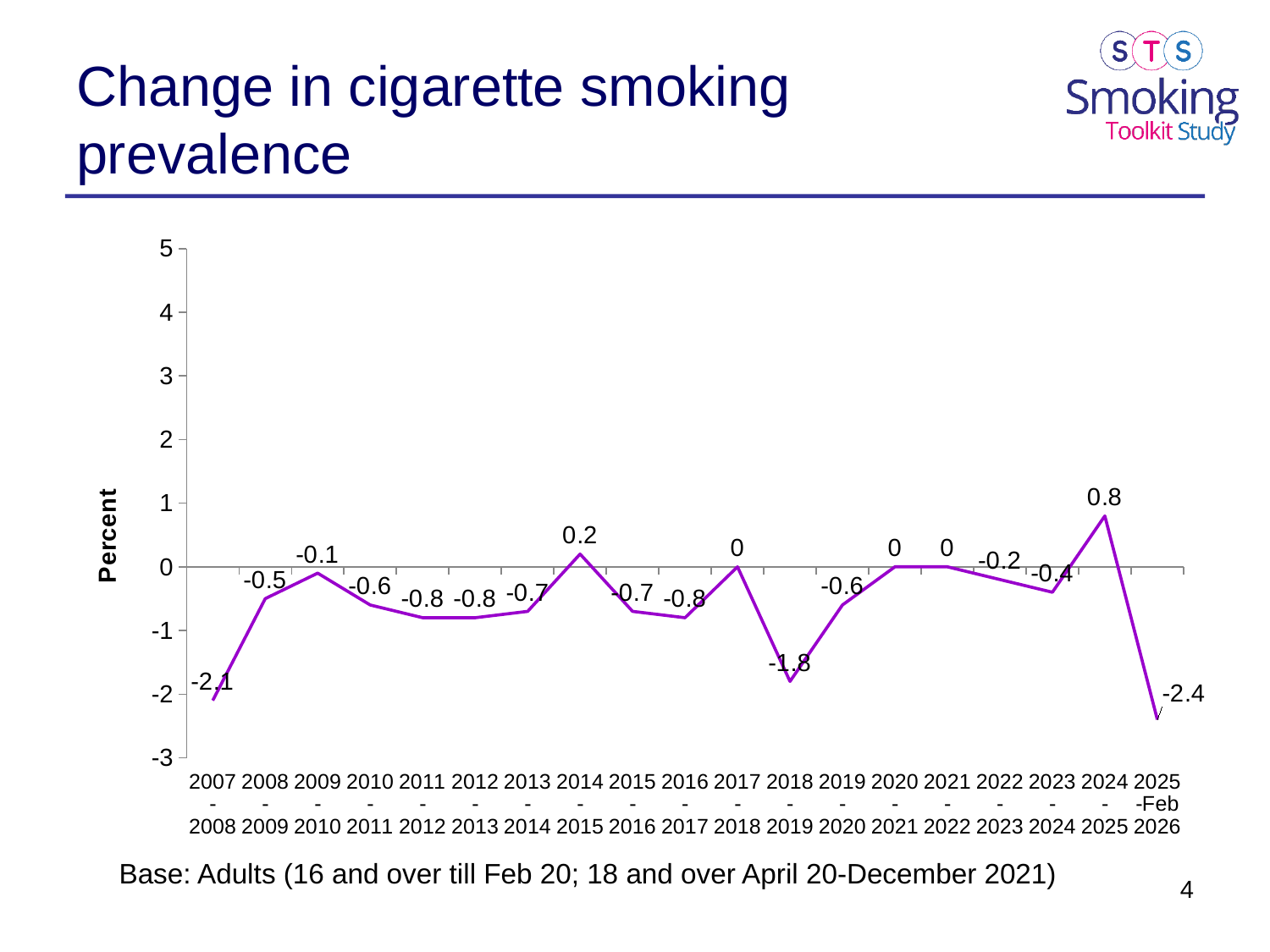
Which period has the lowest value? 2025-Feb 2026 What is the value for 2014-2015? 0.2 What is the value for 2025-Feb 2026? -2.4 Which is larger, the value for 2009-2010 or the value for 2011-2012? 2009-2010 What is the value for 2018-2019? -1.8 What is the label on the y axis? Percent Which period has the highest value? 2024-2025 What is the value for 2024-2025? 0.8 What is the difference between the values for 2024-2025 and 2025-Feb 2026? 3.2 How many periods are plotted on the x axis? 19 What is the value for 2007-2008? -2.1 What kind of chart is shown on the slide? Line chart